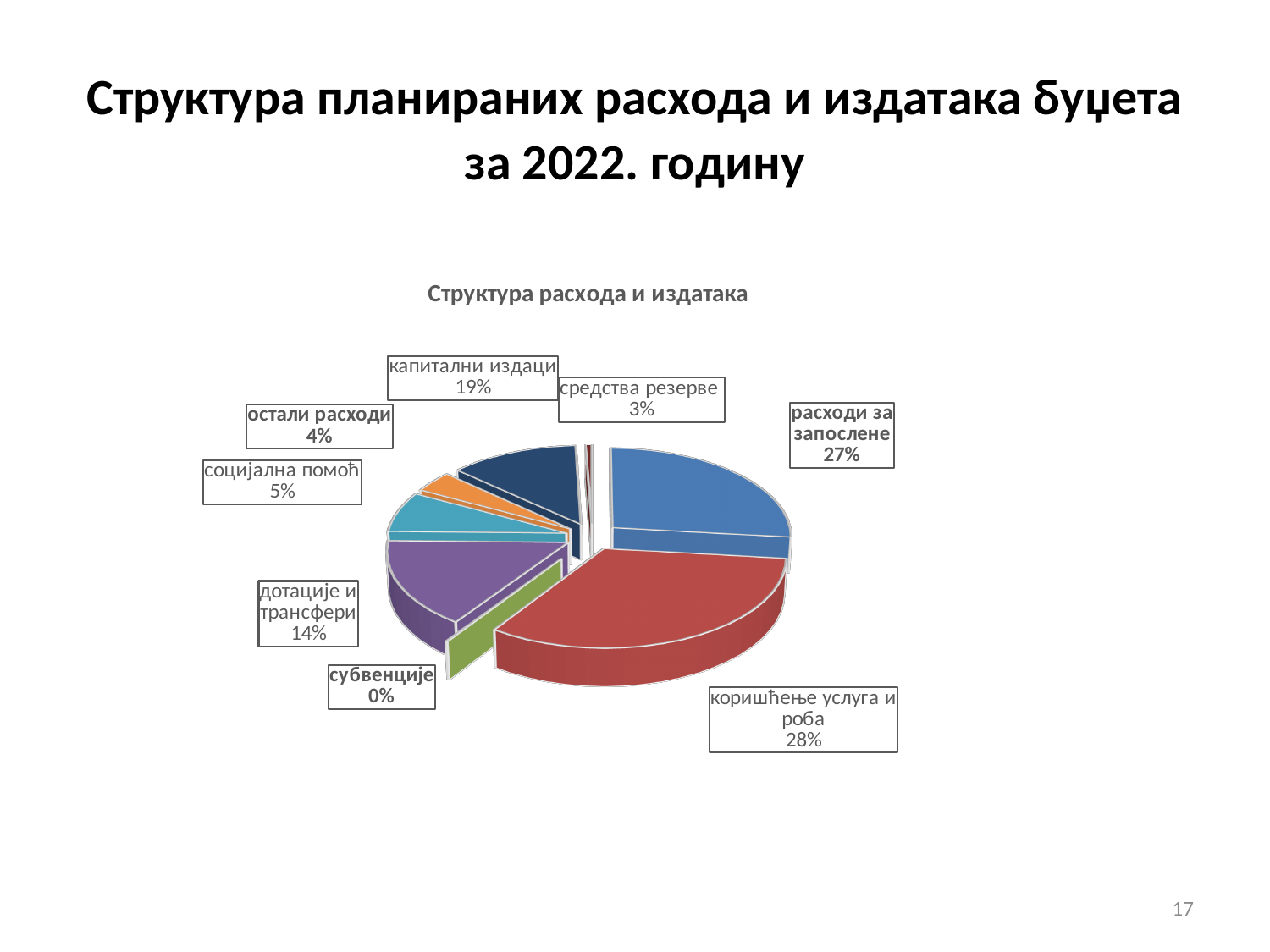
What kind of chart is shown on the slide? pie chart What is the share for средства резерве? 3% How many categories are shown in the pie chart? 8 Which is larger, the share for социјална помоћ or the share for остали расходи? социјална помоћ What is the difference between the shares of капитални издаци and дотације и трансфери? 5% What is the share for дотације и трансфери? 14% What is the share for капитални издаци? 19% What is the title of the chart? Структура расхода и издатака Which category has the largest share of the pie? коришћење услуга и роба What is the share for расходи за запослене? 27% What is the share for коришћење услуга и роба? 28% Which category has the smallest share of the pie? субвенције